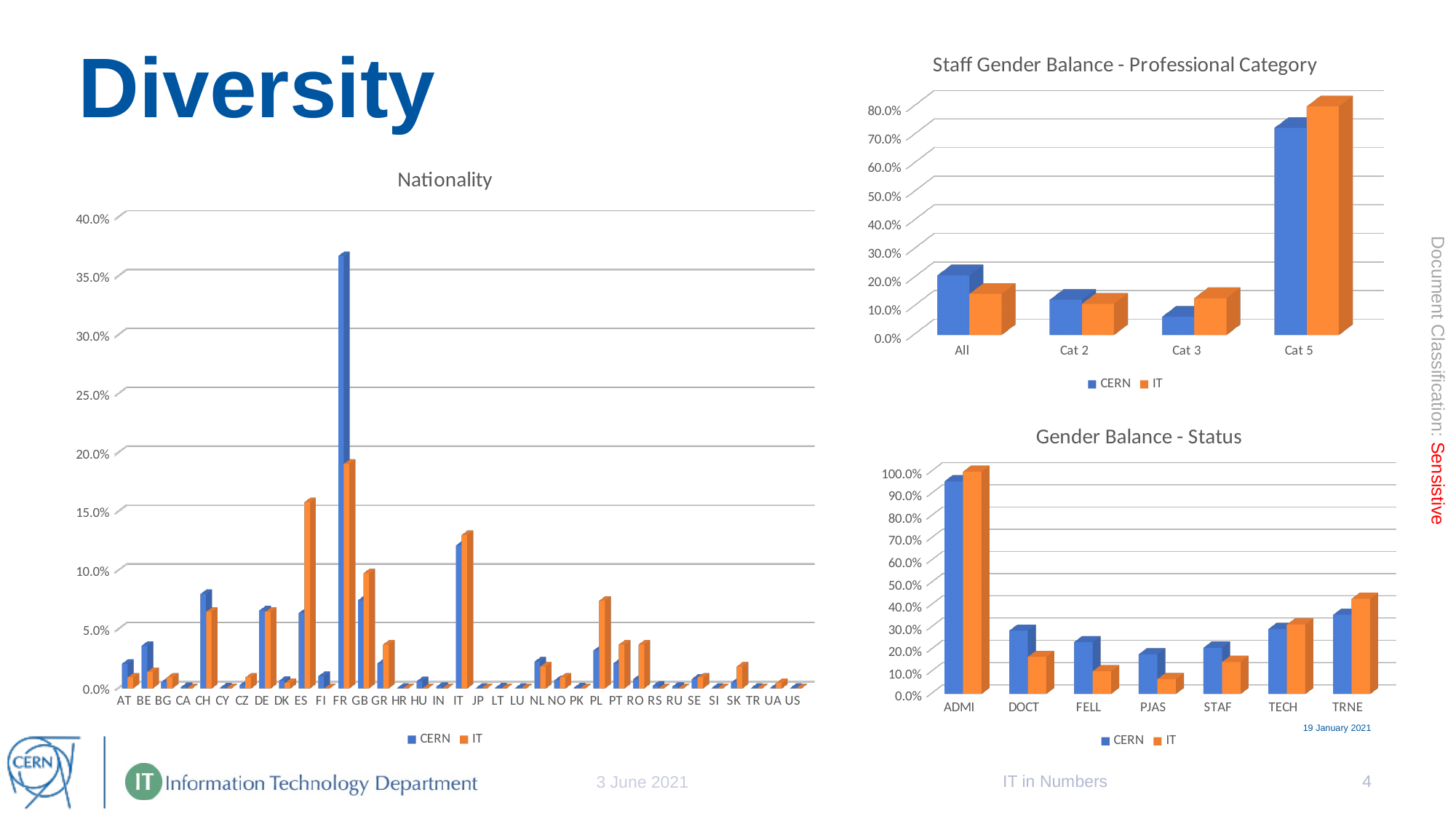
In the Nationality chart, how many nationality categories are shown on the x axis? 35 In the Staff Gender Balance - Professional Category chart, which is larger for Cat 3, CERN or IT? IT In the Staff Gender Balance - Professional Category chart, is the CERN value for Cat 5 greater or less than 70.0%? greater In the Nationality chart, is the CERN value for FR greater or less than 35.0%? greater What kind of chart is the Gender Balance - Status chart? bar chart In the Gender Balance - Status chart, is the CERN value for DOCT greater or less than 20.0%? greater In the Staff Gender Balance - Professional Category chart, how many categories are shown on the x axis? 4 In the Gender Balance - Status chart, which status has the highest CERN value? ADMI In the Staff Gender Balance - Professional Category chart, which category has the highest IT value? Cat 5 In the Nationality chart, how many series does the legend list? 2 In the Nationality chart, which nationality has the highest CERN value? FR